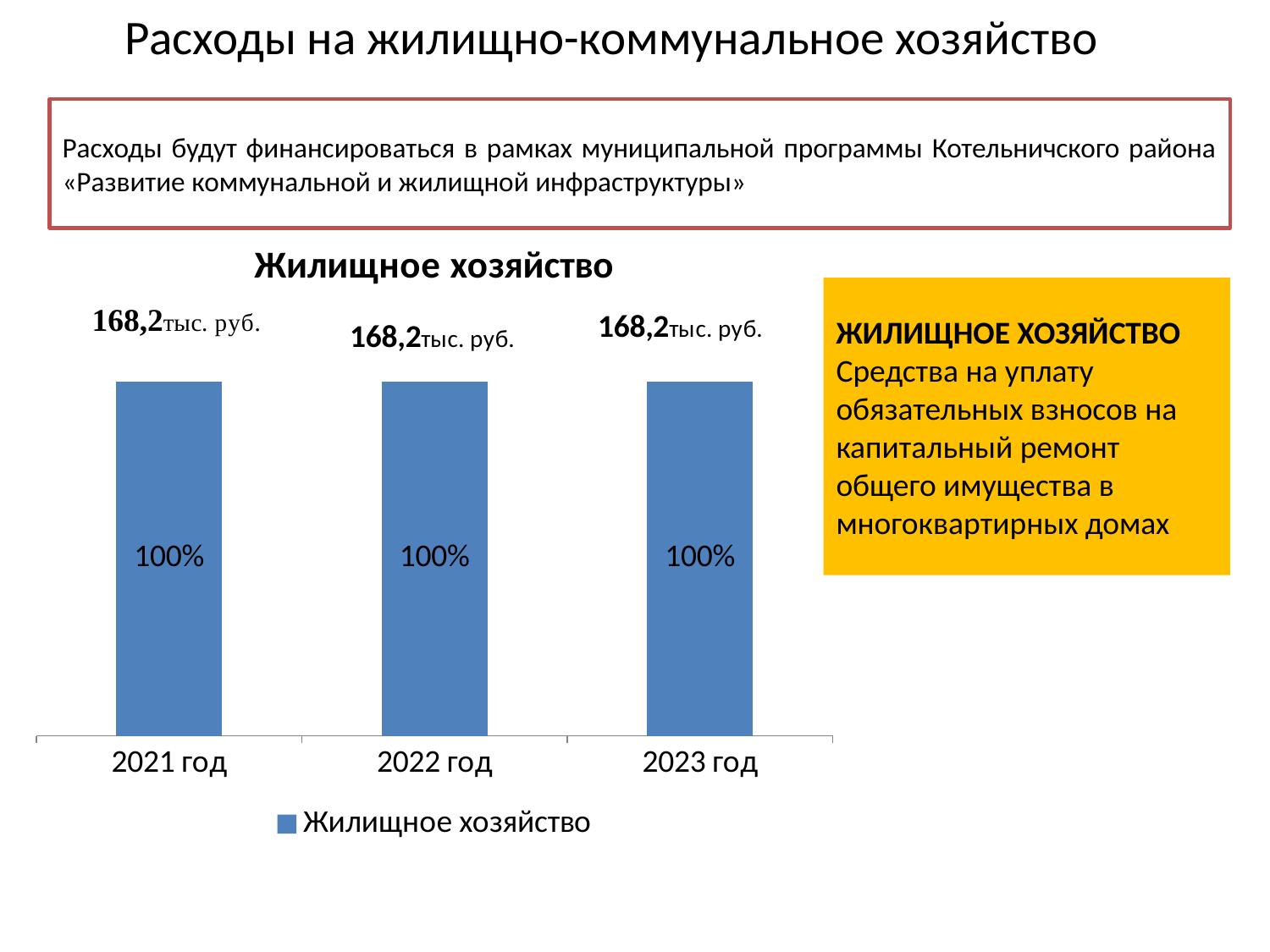
What kind of chart is shown on the slide? bar chart What percentage is labelled on the bar for 2021 год? 100% How many series does the chart legend list? 1 What is the title of the chart? Жилищное хозяйство Do the values rise, fall, or stay the same from 2021 год to 2023 год? stay the same Is the amount for 2022 год larger than, smaller than, or equal to the amount for 2023 год? equal What is the difference between the amounts shown for 2023 год and 2021 год? 0 What amount in тыс. руб. is shown above the bar for 2022 год? 168,2 тыс. руб. How many categories (years) are shown on the x axis of the chart? 3 What series name is shown in the chart legend? Жилищное хозяйство What percentage is labelled on the bar for 2023 год? 100% What amount in тыс. руб. is shown above the bar for 2021 год? 168,2 тыс. руб.